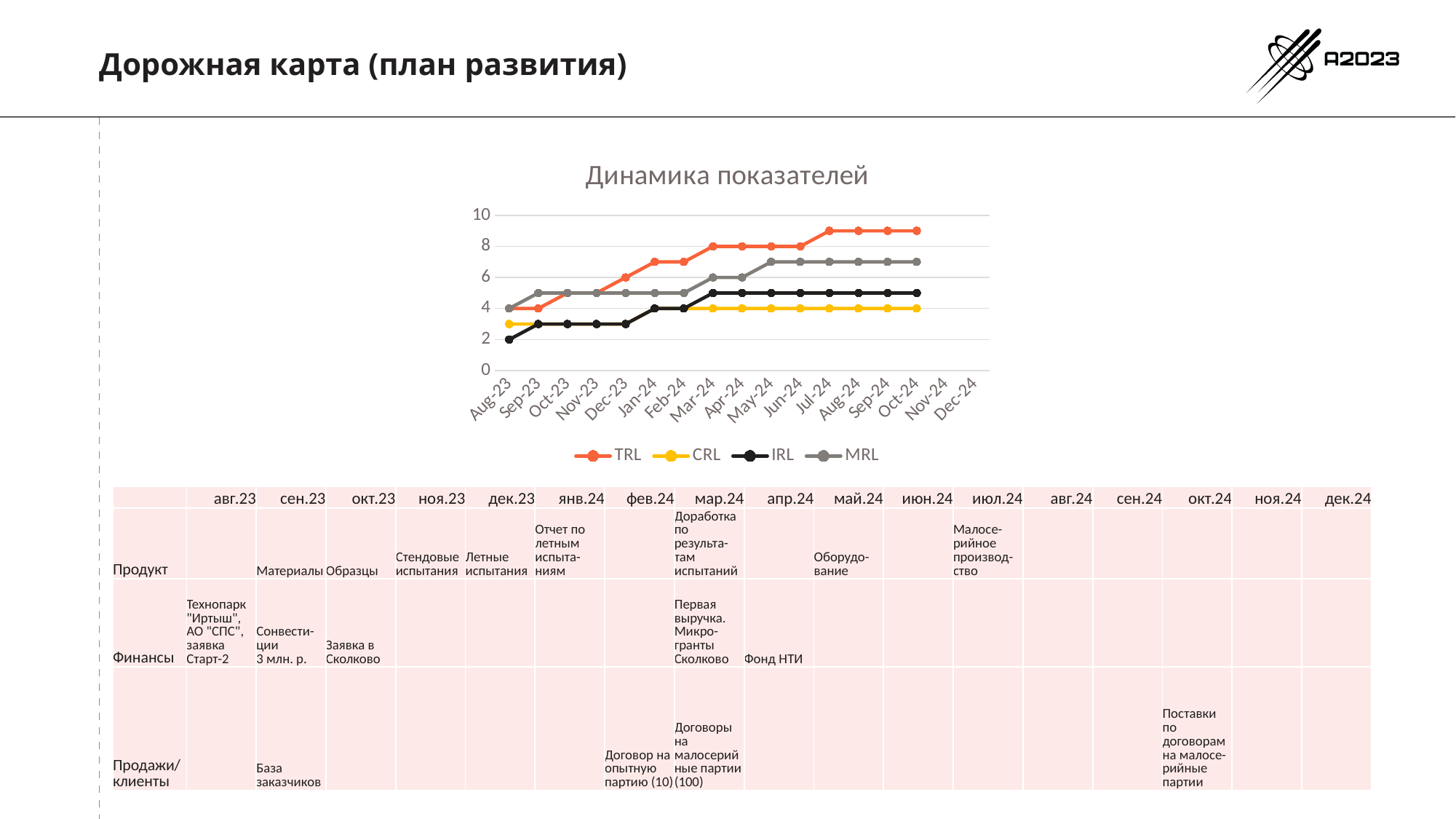
Is the CRL value in Aug-23 greater or less than 4? less What is the difference between the TRL and CRL values in Mar-24? 4 What is the MRL value in Mar-24 in "Динамика показателей"? 6 Which series has the highest value in Oct-24 in "Динамика показателей"? TRL What kind of chart is "Динамика показателей"? line chart How many months are labelled on the x axis of "Динамика показателей"? 17 Is the TRL value in Oct-24 greater or less than 8? greater Does the TRL series rise or fall from Aug-23 to Oct-24? rise What is the TRL value in Mar-24 in "Динамика показателей"? 8 What is the IRL value in Aug-23 in "Динамика показателей"? 2 How many series does the legend of "Динамика показателей" list? 4 Which series has the lowest value in Oct-24 in "Динамика показателей"? CRL